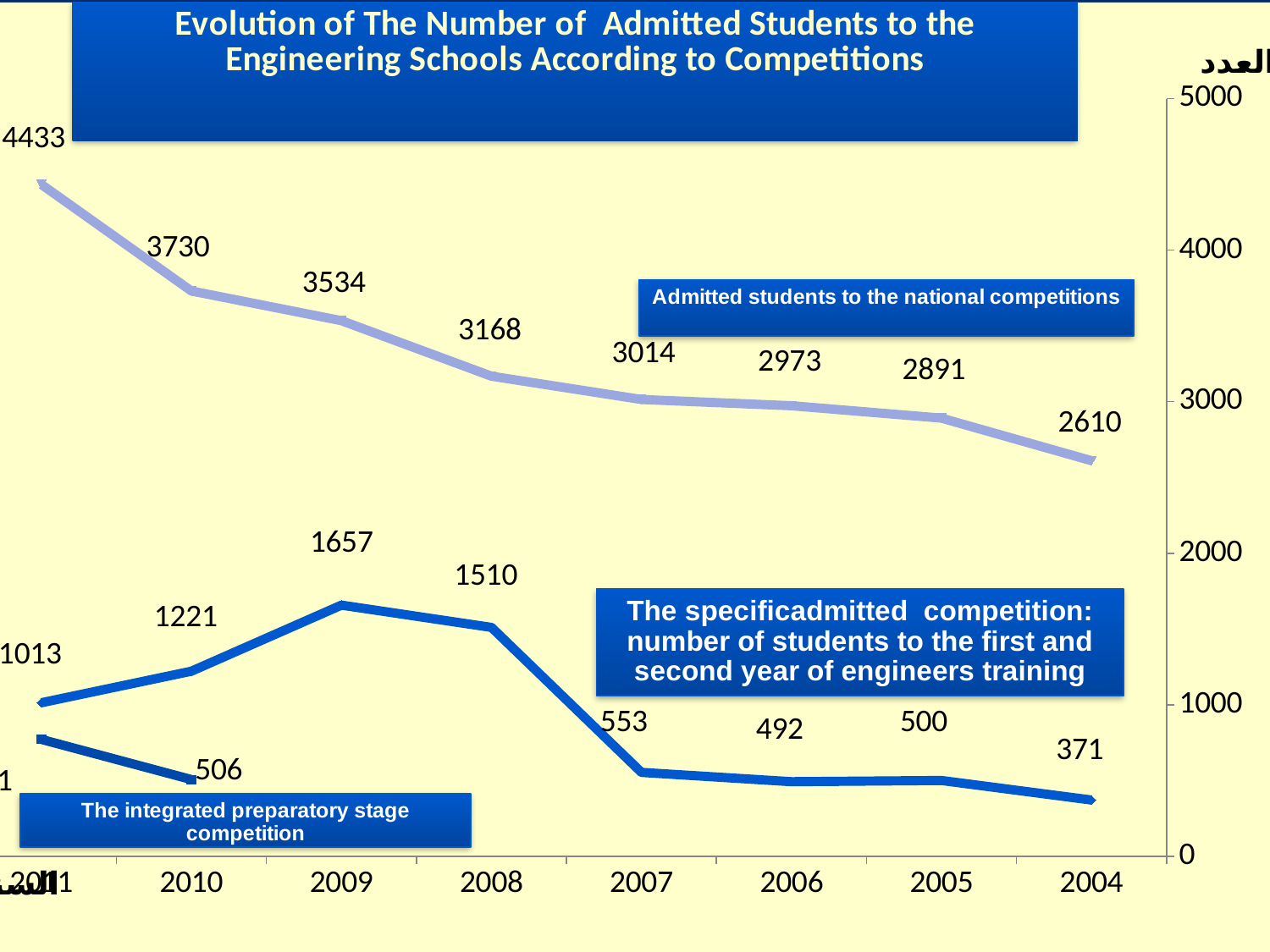
In which year is the specific competition series at its highest? 2009 What is the value for the specific competition series in 2009? 1657 In which year is the specific competition series at its lowest? 2004 Which is larger: the specific competition value in 2005 or in 2006? 2005 What is the value for the integrated preparatory stage competition in 2010? 506 What is the difference between the national competitions values for 2011 and 2010? 703 How many years are shown on the x axis? 8 What is the value for the national competitions series in 2004? 2610 Does the national competitions line rise or fall moving from 2011 on the left to 2004 on the right? fall What is the difference between the specific competition values for 2008 and 2007? 957 What type of chart is shown on the slide? line chart How many admitted students to the national competitions were there in 2011? 4433